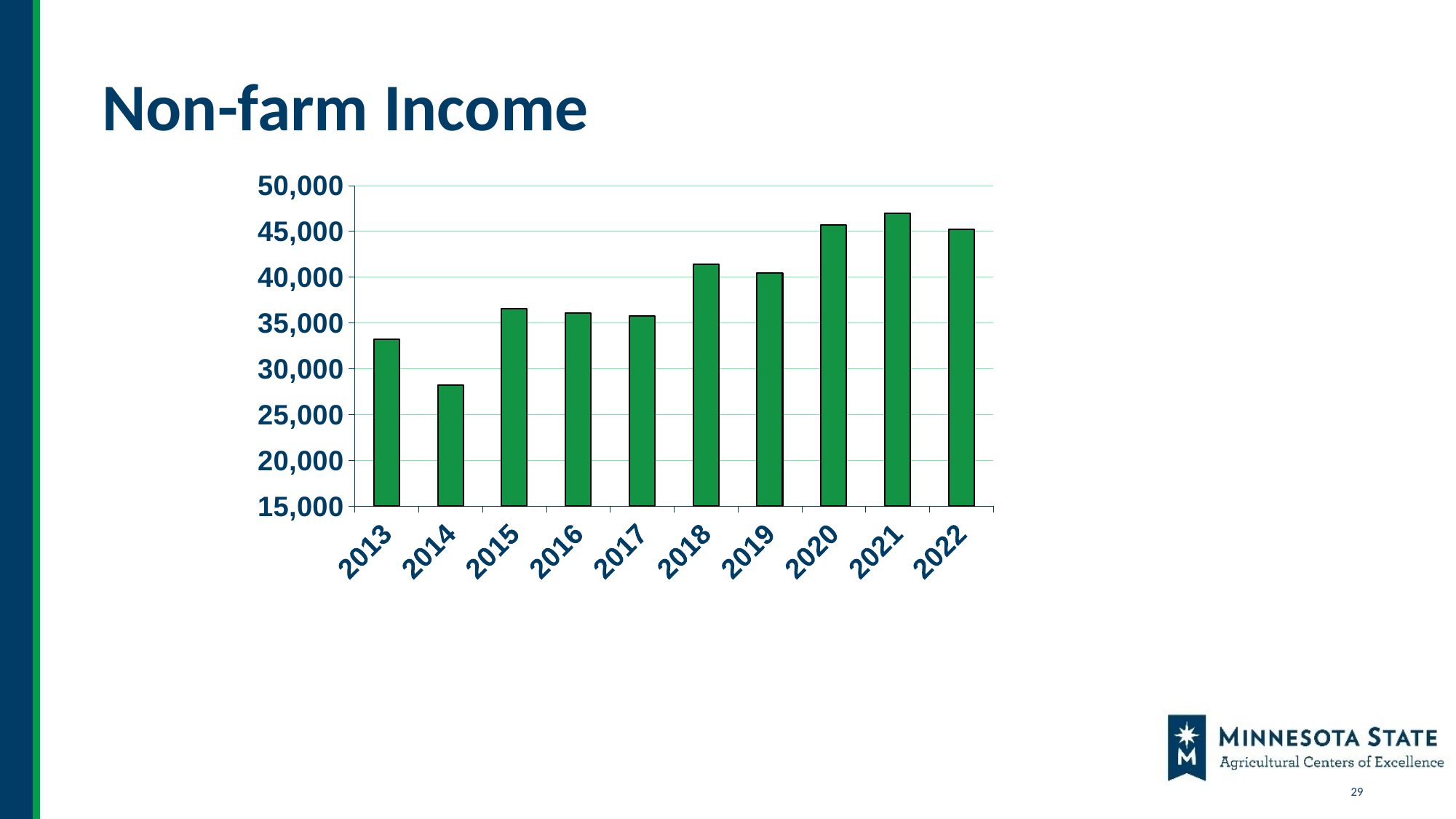
Which year has the lowest non-farm income? 2014 What is the title of the chart? Non-farm Income Is the value for 2021 greater or less than 45,000? greater Is the value for 2013 greater or less than 35,000? less Which year has the larger non-farm income, 2018 or 2019? 2018 How many years are shown on the x axis of the chart? 10 Which year has the highest non-farm income? 2021 Is the value for 2018 greater or less than 40,000? greater Which year has the larger non-farm income, 2013 or 2014? 2013 What kind of chart is shown on the slide? bar chart Overall, do the values rise or fall from 2013 to 2022? rise